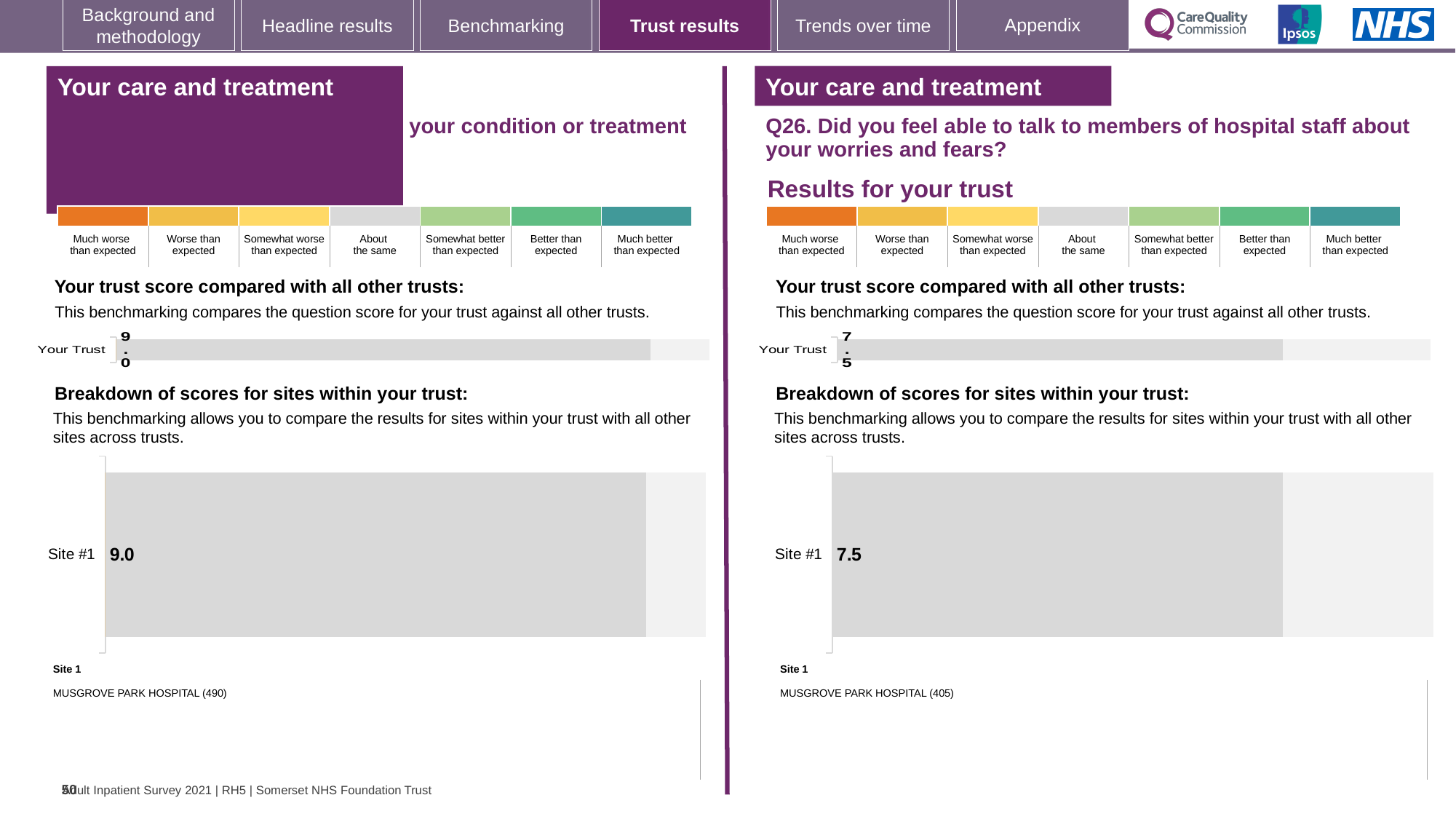
Which is larger: the Your Trust score on the left panel or the Your Trust score on the right panel (Q26)? Left panel What is the question text shown above the charts on the right panel? Q26. Did you feel able to talk to members of hospital staff about your worries and fears? On the left panel, what score is shown for Site #1 in the 'Breakdown of scores for sites within your trust' chart? 9.0 How many sites are shown in the 'Breakdown of scores for sites within your trust' chart on the right panel (Q26)? 1 On the right panel (Q26), what is the value shown for Your Trust in the 'Your trust score compared with all other trusts' chart? 7.5 On the right panel (Q26), is the Your Trust score greater or less than the Site #1 score, or are they equal? Equal What is the difference between the Site #1 score on the left panel and the Site #1 score on the right panel (Q26)? 1.5 On the left panel, what is the value shown for Your Trust in the 'Your trust score compared with all other trusts' chart? 9.0 How many sites are shown in the 'Breakdown of scores for sites within your trust' chart on the left panel? 1 What type of chart is used to show the Site #1 score on the right panel (Q26)? Bar chart Which hospital is listed as Site 1 on the right panel (Q26)? MUSGROVE PARK HOSPITAL (405) On the right panel (Q26), what score is shown for Site #1 in the 'Breakdown of scores for sites within your trust' chart? 7.5